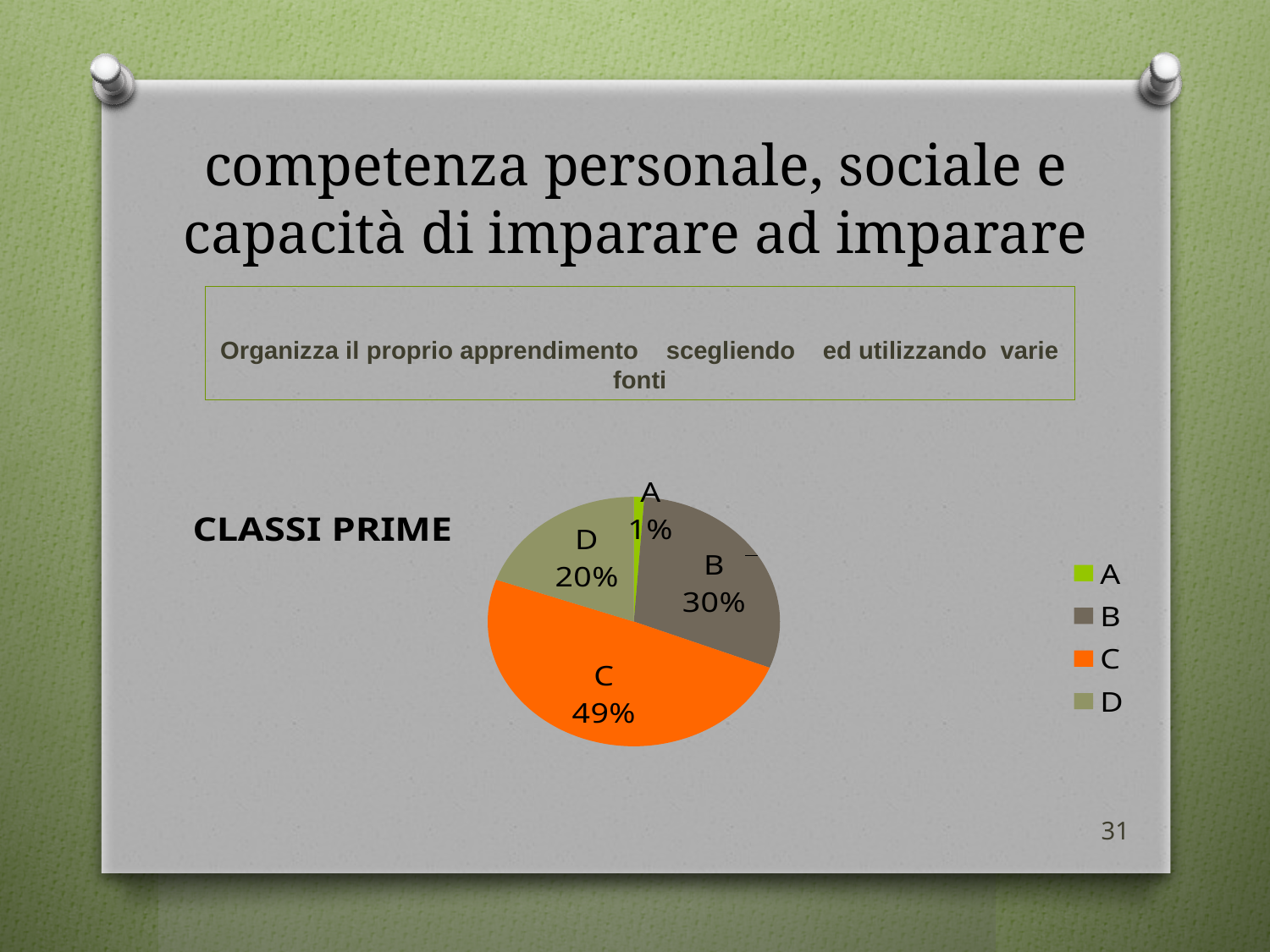
How many slices does the pie chart have? 4 Which is larger, the share for B or the share for D? B What percentage does slice B represent in the pie chart? 30% What colour is the slice for category C in the pie chart? orange What kind of chart is shown on the slide? pie chart What percentage does slice C represent in the pie chart? 49% Which category has the smallest share of the pie chart? A Which category has the largest share of the pie chart? C How many entries does the legend list? 4 What percentage does slice D represent in the pie chart? 20% What is the difference in percentage points between slice C and slice B? 19 What percentage does slice A represent in the pie chart? 1%